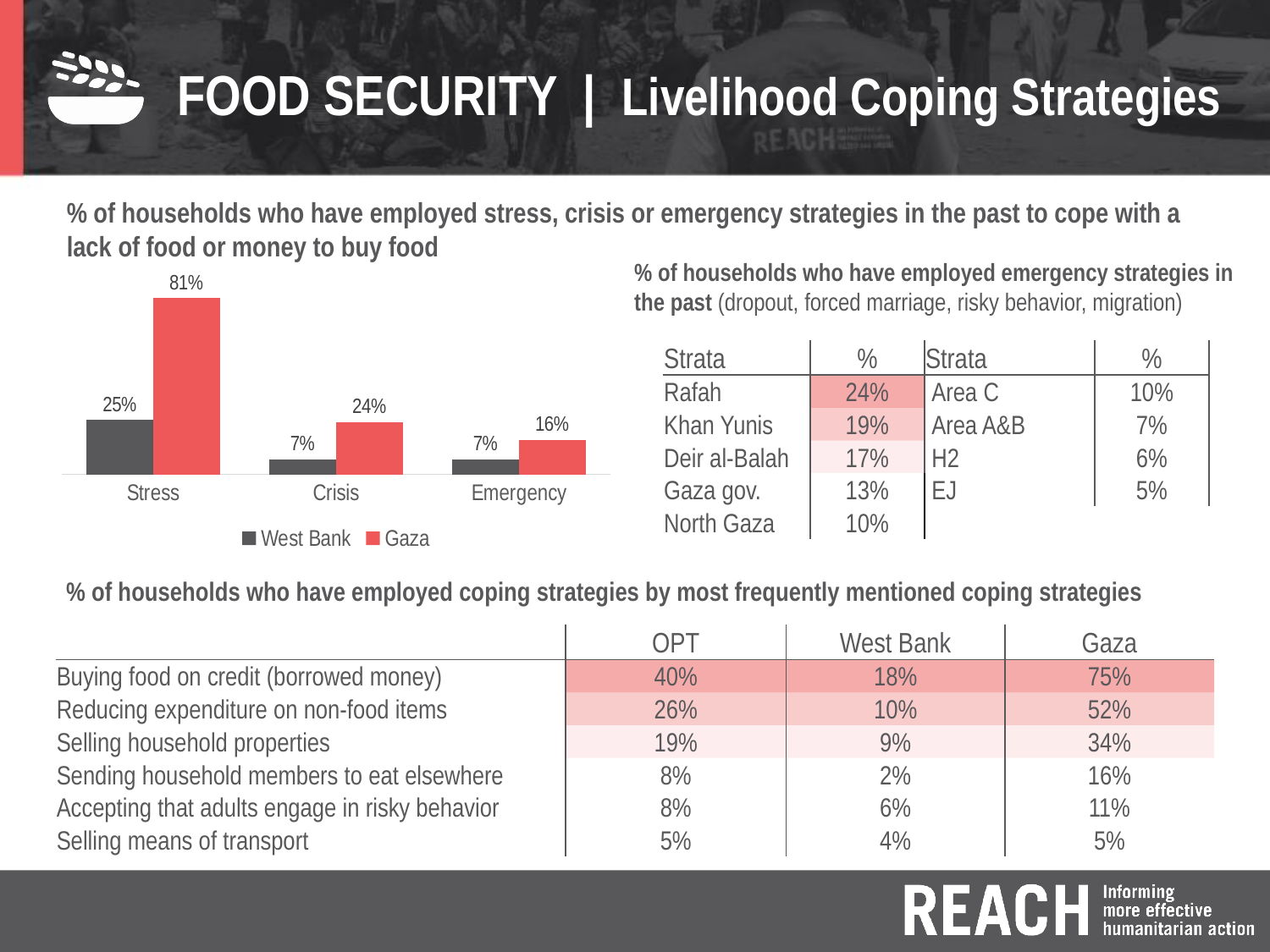
Which category has the highest value for Gaza? Stress What percentage of households in the West Bank employed stress strategies? 25% How many categories are shown on the x axis of the bar chart? 3 What is the difference between the Gaza and West Bank values for Stress? 56% What is the difference between the Gaza and West Bank values for Emergency? 9% What is the value for the West Bank in the Emergency category? 7% What percentage of households in Gaza employed stress strategies? 81% What type of chart is used to show stress, crisis and emergency strategies? Bar chart Which category has the lowest value for Gaza? Emergency What is the value for Gaza in the Crisis category? 24% Which is larger, the Gaza value for Crisis or the West Bank value for Stress? West Bank value for Stress How many series does the legend of the bar chart list? 2